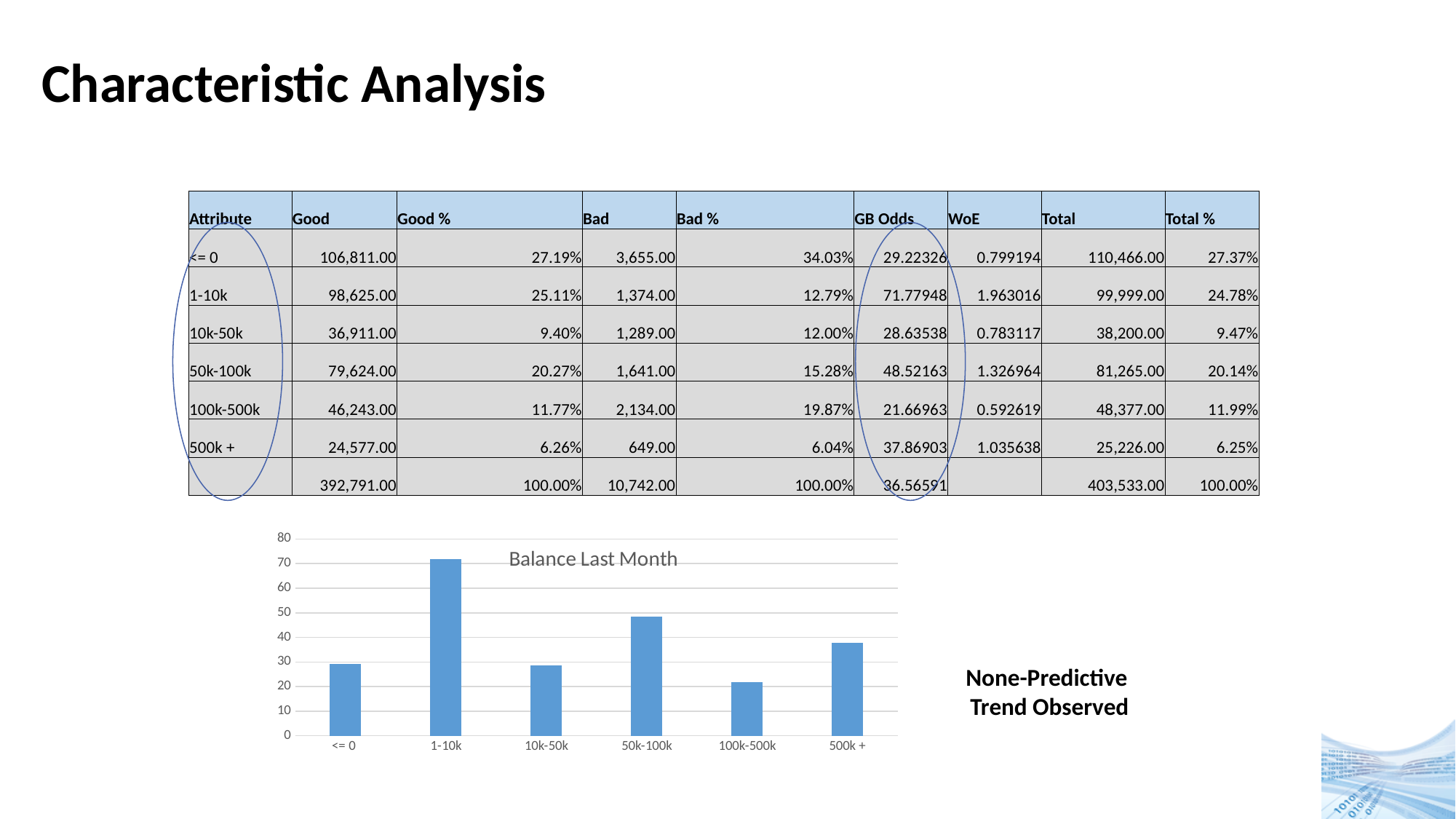
Is the value for 1-10k greater or less than 60? greater Is the value for 50k-100k greater or less than 40? greater What kind of chart is shown on the slide? bar chart Which has the larger value in the chart, 50k-100k or 500k +? 50k-100k What is the highest value shown on the chart's y axis? 80 Is the value for 100k-500k greater or less than 30? less Which category has the lowest bar in the chart? 100k-500k Which category has the highest bar in the chart? 1-10k How many categories are shown on the x axis of the chart? 6 Which has the larger value in the chart, 1-10k or 50k-100k? 1-10k What is the title of the chart? Balance Last Month